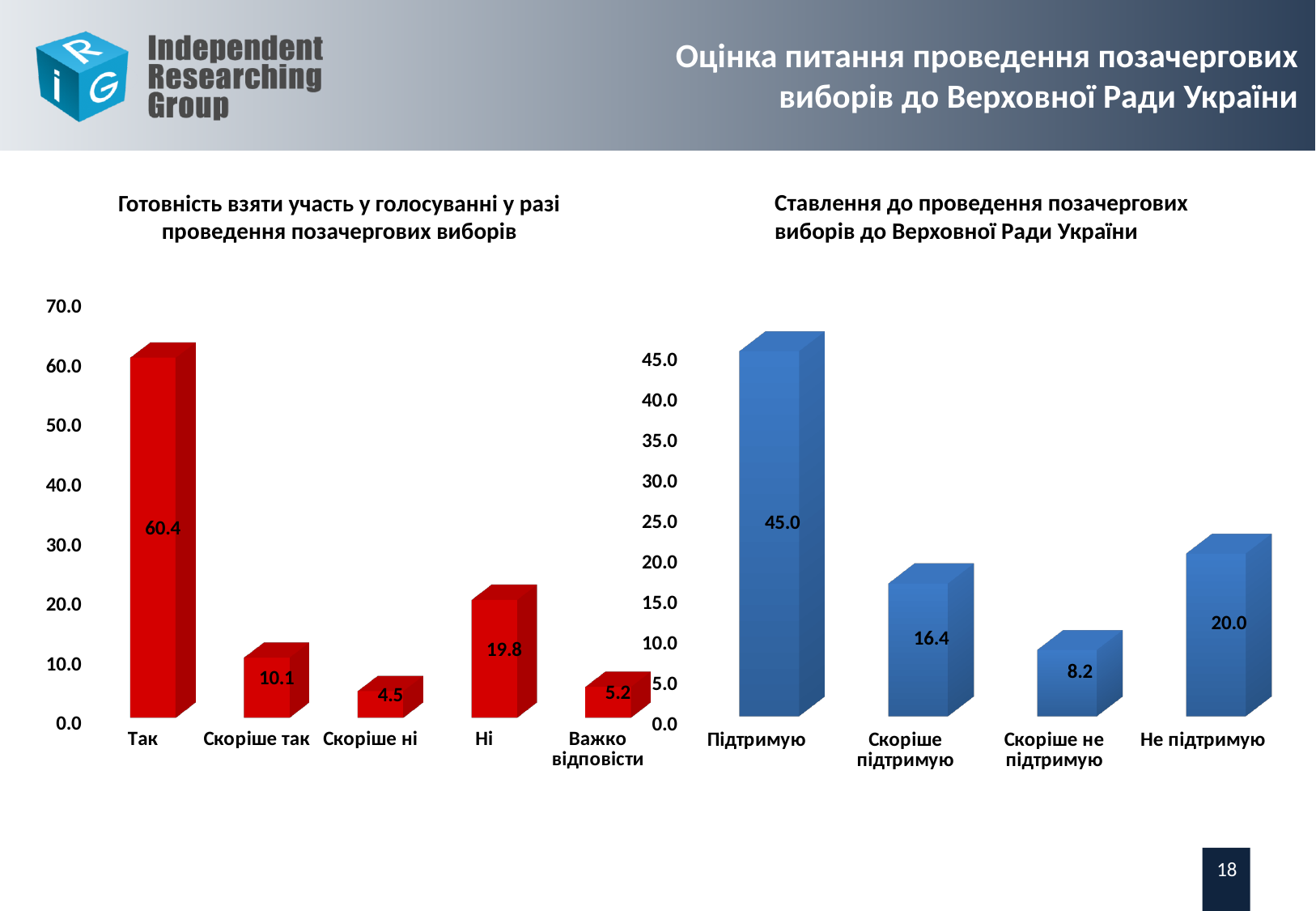
In the right chart, which category has the highest value? Підтримую In the right chart (Ставлення до проведення позачергових виборів до Верховної Ради України), what is the value for Підтримую? 45.0 In the right chart, what is the difference between the values for Не підтримую and Скоріше підтримую? 3.6 In the right chart, what is the value for Скоріше не підтримую? 8.2 In the left chart, which is larger: Скоріше так or Важко відповісти? Скоріше так In the left chart, what is the difference between the values for Так and Ні? 40.6 In the left chart (Готовність взяти участь у голосуванні у разі проведення позачергових виборів), what is the value for Так? 60.4 What type of chart is the right chart? Bar chart In the left chart, which category has the lowest value? Скоріше ні In the left chart, what is the value for Скоріше ні? 4.5 What colour are the bars in the left chart? Red How many categories are shown in the left chart? 5